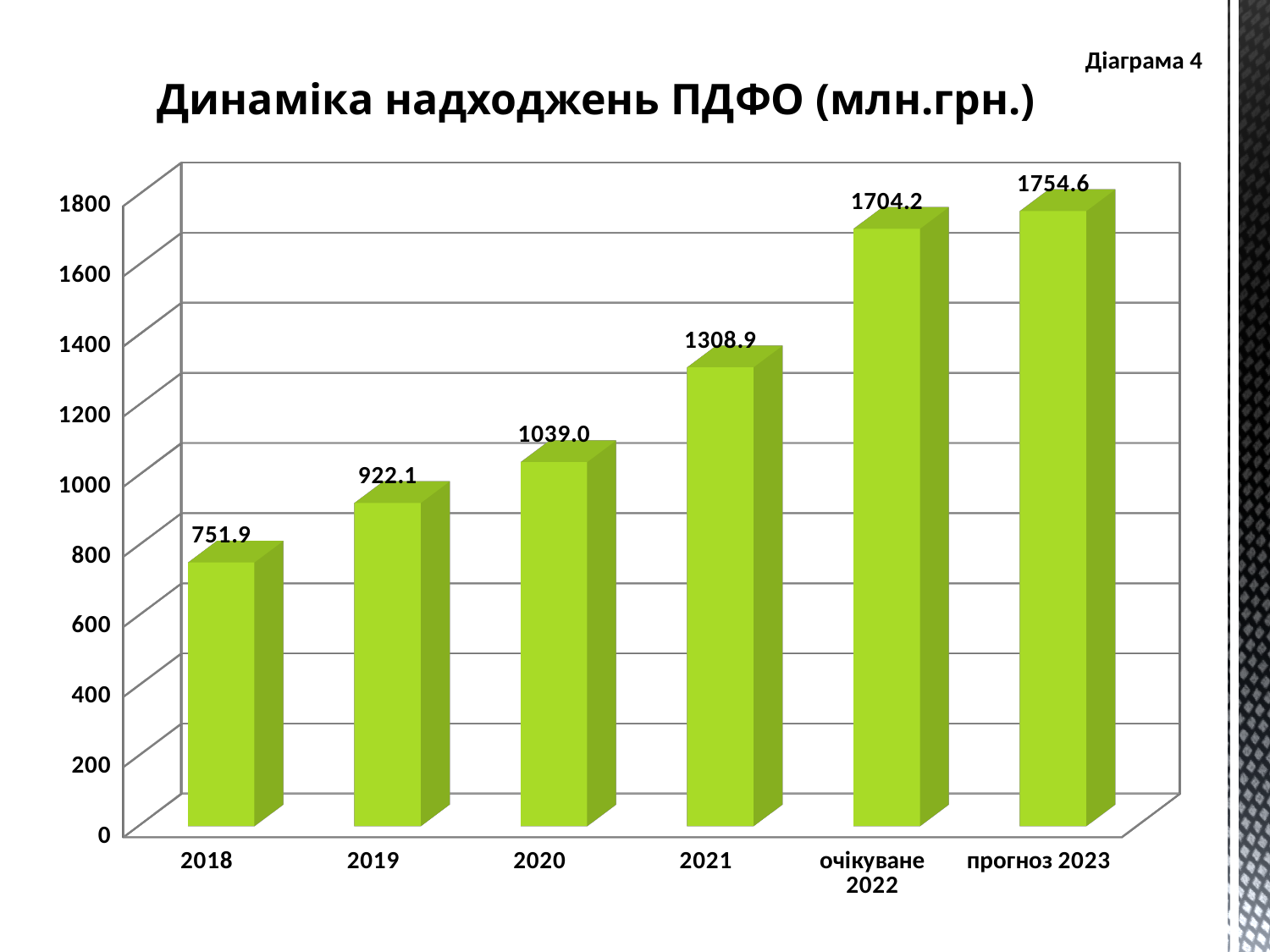
What is the difference between the values for 2021 and 2020? 269.9 How many categories are shown on the x axis? 6 What is the value for очікуване 2022? 1704.2 What is the difference between the values for прогноз 2023 and очікуване 2022? 50.4 What is the value for 2020? 1039.0 Which category has the lowest value? 2018 Which category has the highest value? прогноз 2023 What is the value for 2018? 751.9 Is the value for 2019 greater or less than 1000? less Which is larger, the value for 2019 or the value for 2021? 2021 What kind of chart is shown on the slide? bar chart Do the values rise or fall from 2018 to прогноз 2023? rise